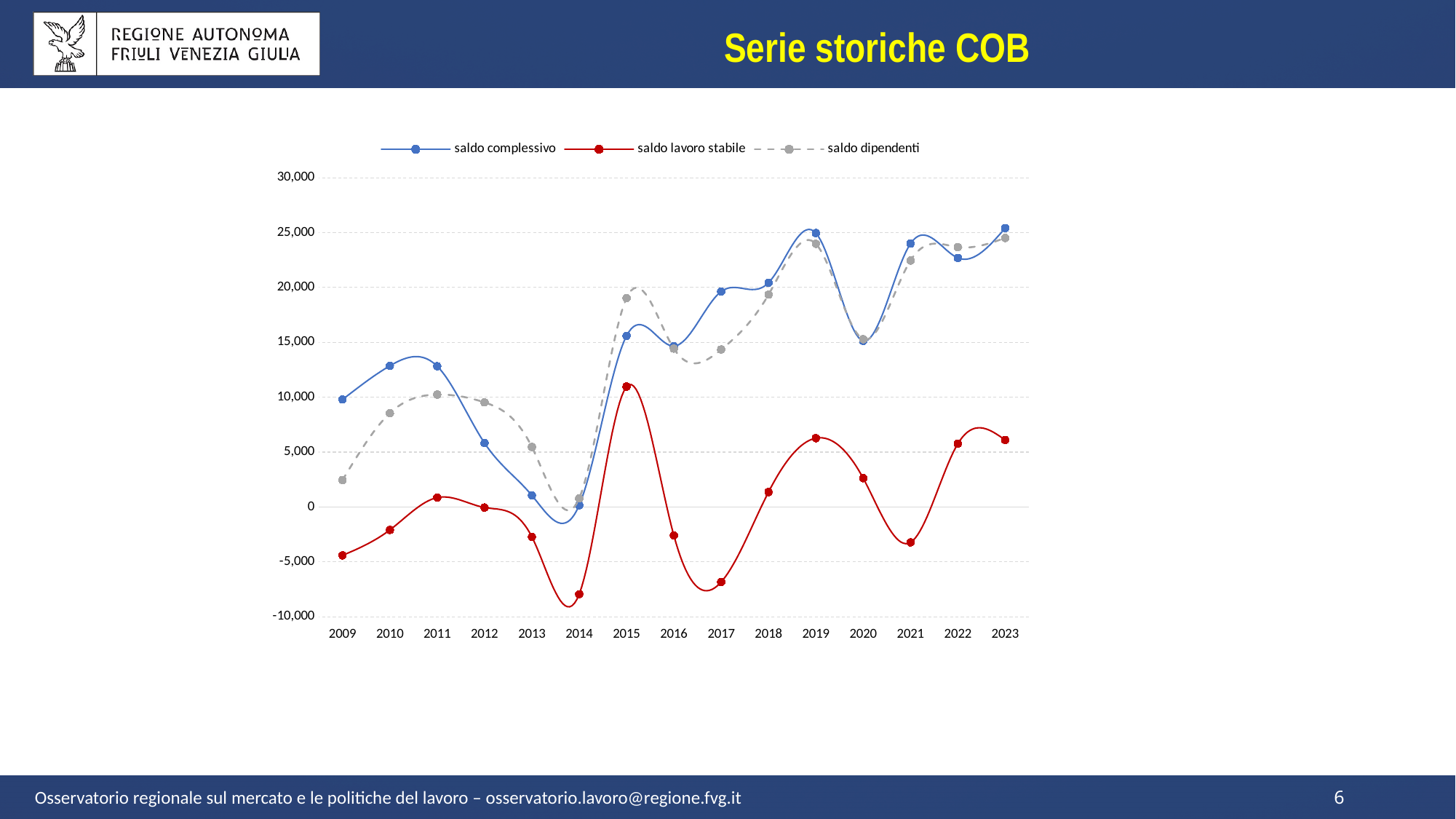
Is the value of saldo lavoro stabile in 2015 greater or less than 10,000? greater How many years are plotted along the x axis? 15 In which year does the saldo lavoro stabile series reach its highest value? 2015 In which year does the saldo lavoro stabile series reach its lowest value? 2014 In 2017, which is larger: saldo complessivo or saldo dipendenti? saldo complessivo Is the value of saldo dipendenti in 2015 greater or less than 20,000? less In which year does the saldo complessivo series reach its lowest value? 2014 Does the saldo complessivo series rise or fall from 2011 to 2014? fall Is the value of saldo lavoro stabile in 2021 greater or less than 0? less How many series does the legend list? 3 What kind of chart is shown on the slide? line chart Which series is drawn with a grey dashed line? saldo dipendenti